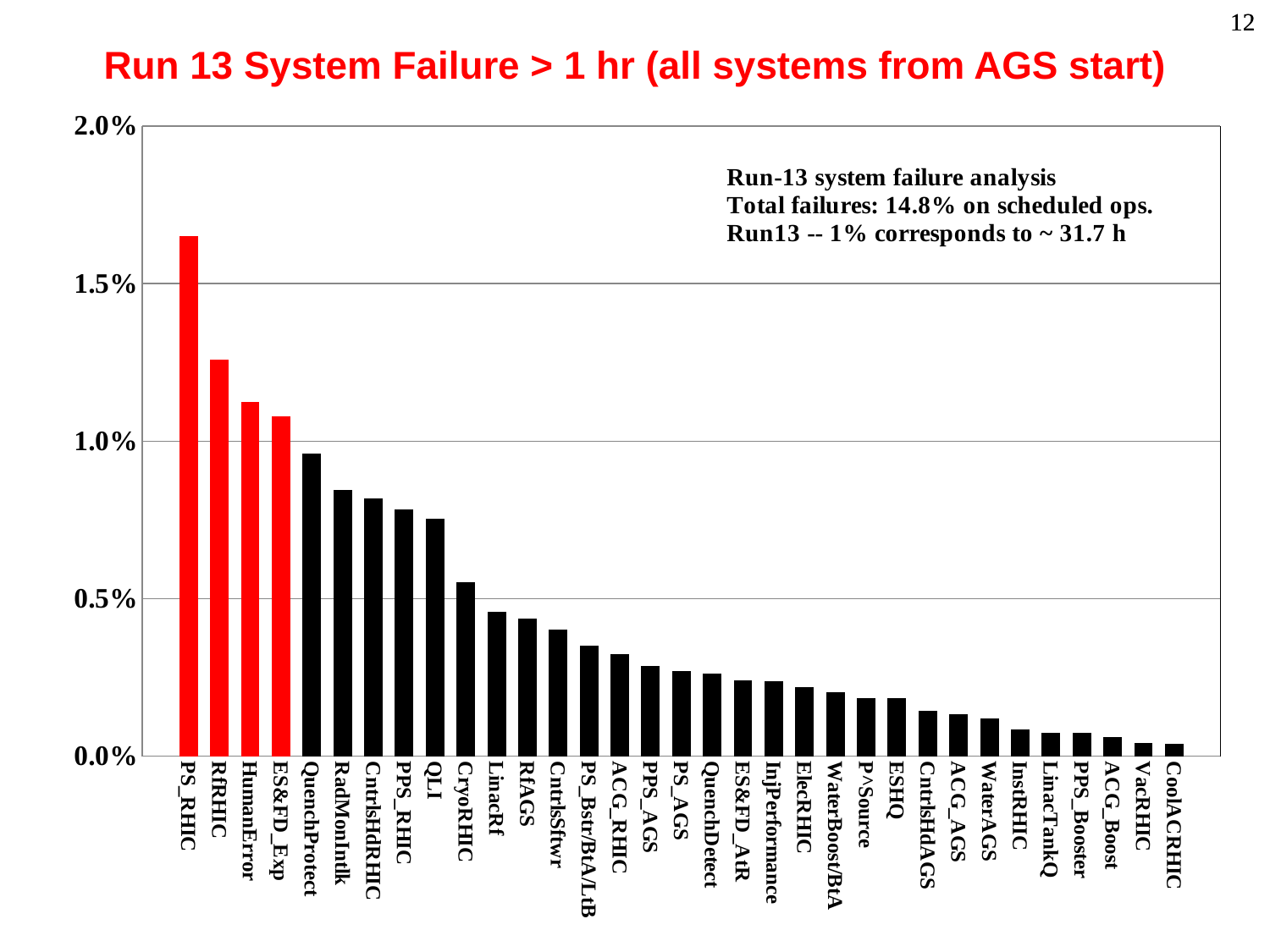
Do the bar values rise or fall from left to right along the x axis? fall Which is larger, the value for PS_RHIC or the value for RfRHIC? PS_RHIC Is the value for PS_RHIC greater or less than 1.5%? greater How many systems (bars) are shown in the chart? 33 Which system has the highest failure percentage? PS_RHIC How many bars are coloured red in the chart? 4 Is the value for QuenchProtect greater or less than 1.0%? less Which is larger, the value for QuenchProtect or the value for CryoRHIC? QuenchProtect Is the value for RfRHIC greater or less than 1.0%? greater What kind of chart is shown on the slide? bar chart